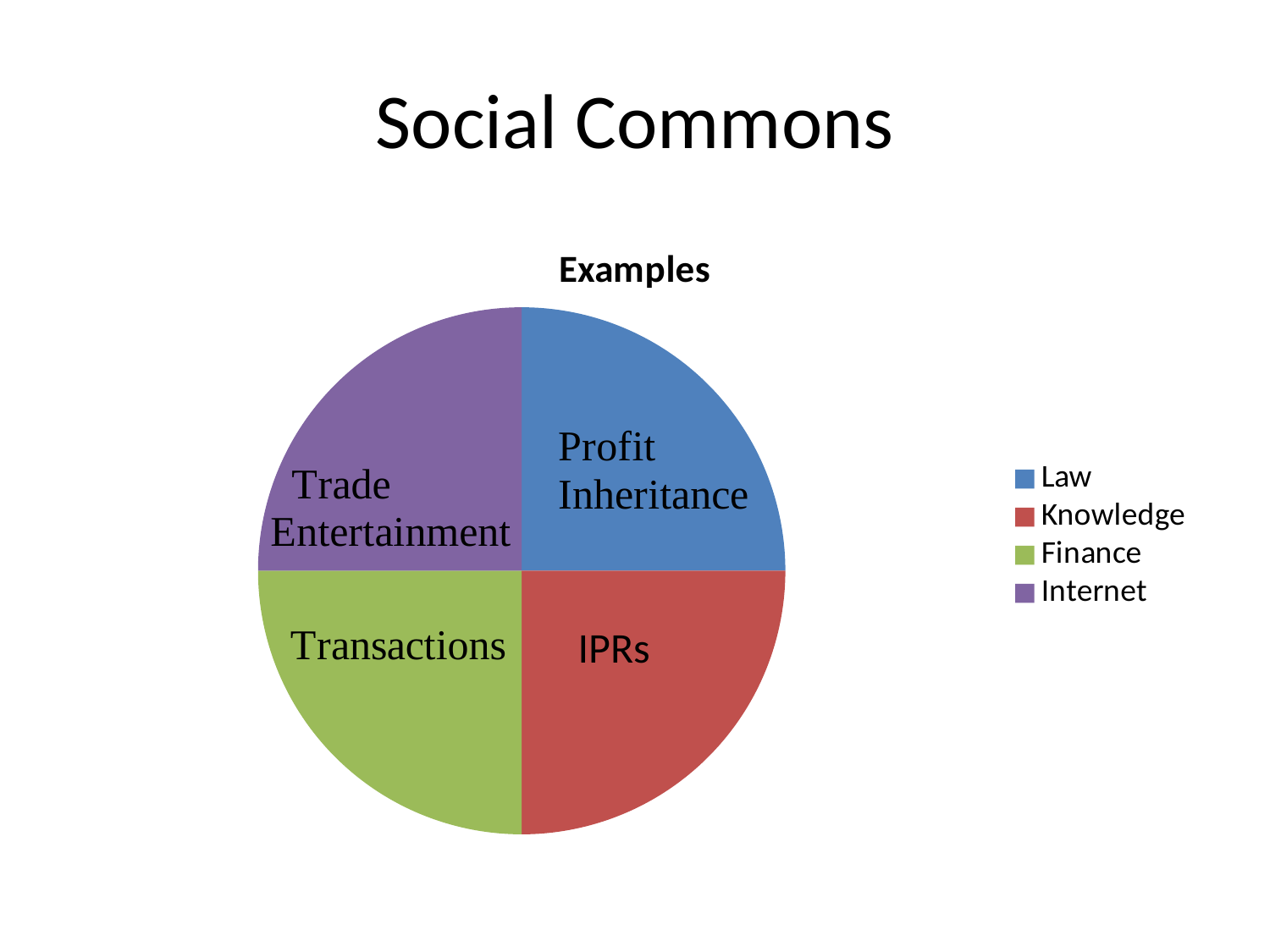
Which text label is placed on the Knowledge slice of the pie chart? IPRs Which legend category does the slice labelled "Profit Inheritance" belong to? Law What is the title of the pie chart? Examples Which legend entry is shown in blue on the pie chart? Law How many entries does the legend of the pie chart list? 4 Which legend category does the slice labelled "Trade Entertainment" belong to? Internet What kind of chart is shown on the slide? pie chart How many slices does the pie chart have? 4 Which text label is placed on the Finance slice of the pie chart? Transactions